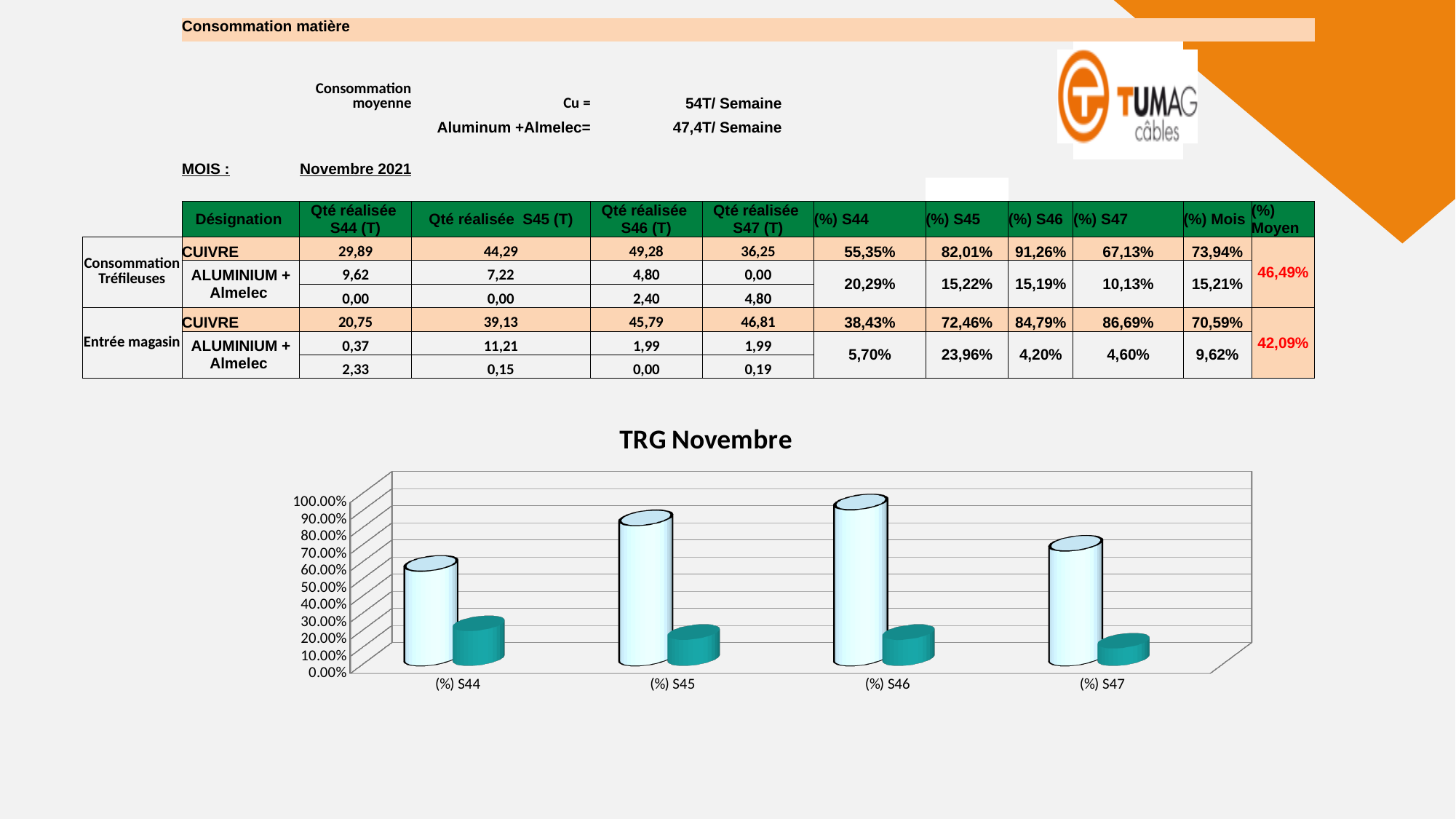
What is the title of the chart on the slide? TRG Novembre In the TRG Novembre chart, is the light blue bar for (%) S47 greater or less than 80.00%? less In the TRG Novembre chart, is the light blue bar for (%) S46 greater or less than 80.00%? greater What kind of chart is shown under the title "TRG Novembre"? bar chart In the TRG Novembre chart, is the light blue bar for (%) S44 greater or less than 50.00%? greater In the TRG Novembre chart, how do the light blue bars change from (%) S44 to (%) S47? rise from S44 to S46, then fall at S47 In the TRG Novembre chart, which category has the tallest light blue bar? (%) S46 How many series of bars are plotted for each category in the TRG Novembre chart? 2 In the TRG Novembre chart, which category has the shortest light blue bar? (%) S44 In the TRG Novembre chart, which light blue bar is taller, (%) S45 or (%) S47? (%) S45 How many categories are shown on the x axis of the TRG Novembre chart? 4